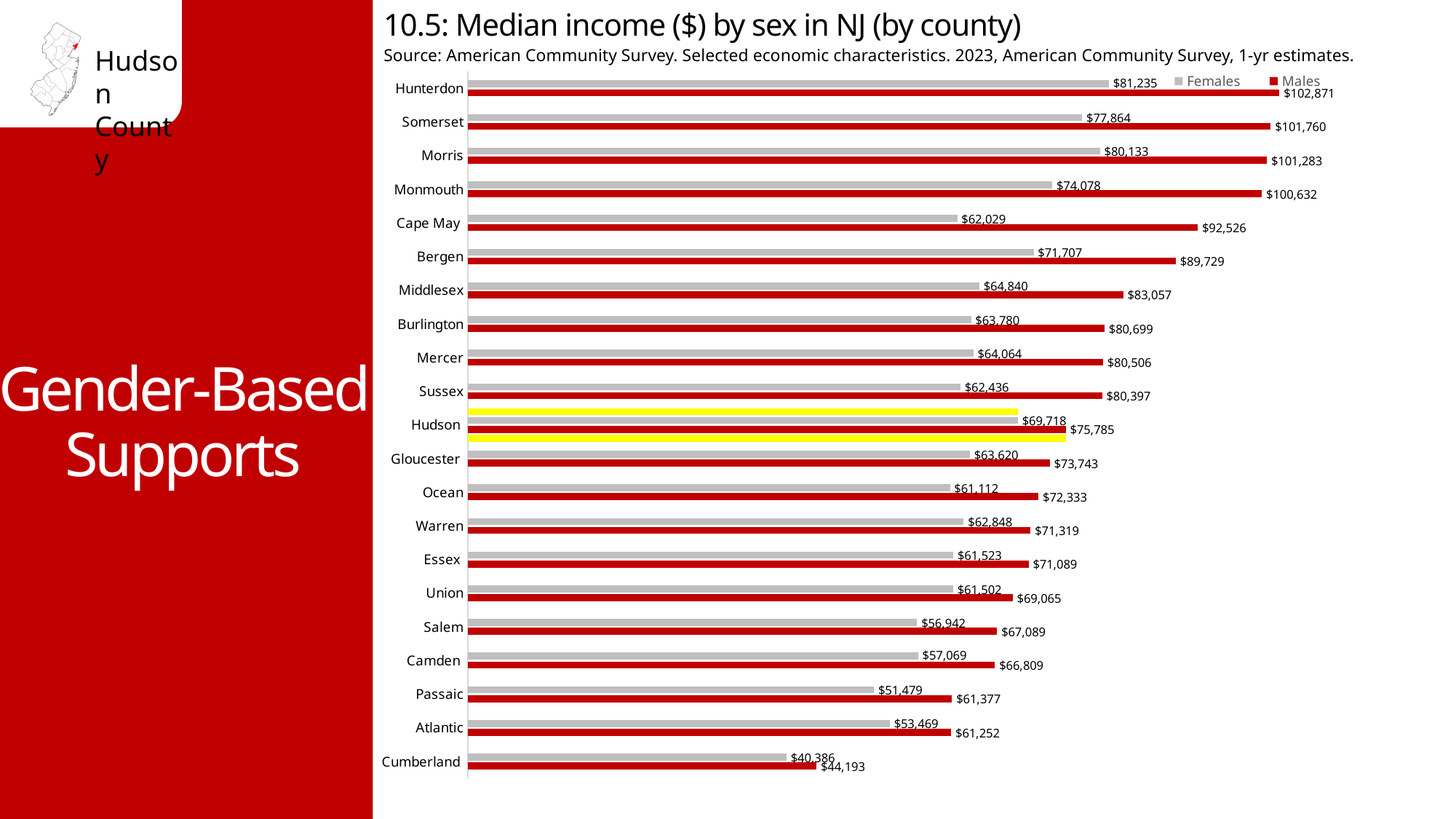
Which is larger, the female median income in Bergen County or in Monmouth County? Monmouth County Which county has the highest median income for males? Hunterdon What is the median income for females in Hudson County? $69,718 Which county has the lowest median income for females? Cumberland What is the median income for males in Hudson County? $75,785 What is the median income for males in Cumberland County? $44,193 How many counties are shown in the chart? 21 What is the difference between the male and female median income in Hunterdon County? $21,636 What kind of chart is shown on the slide? Bar chart What is the median income for females in Hunterdon County? $81,235 What is the difference between the male and female median income in Hudson County? $6,067 How many series does the legend list? 2